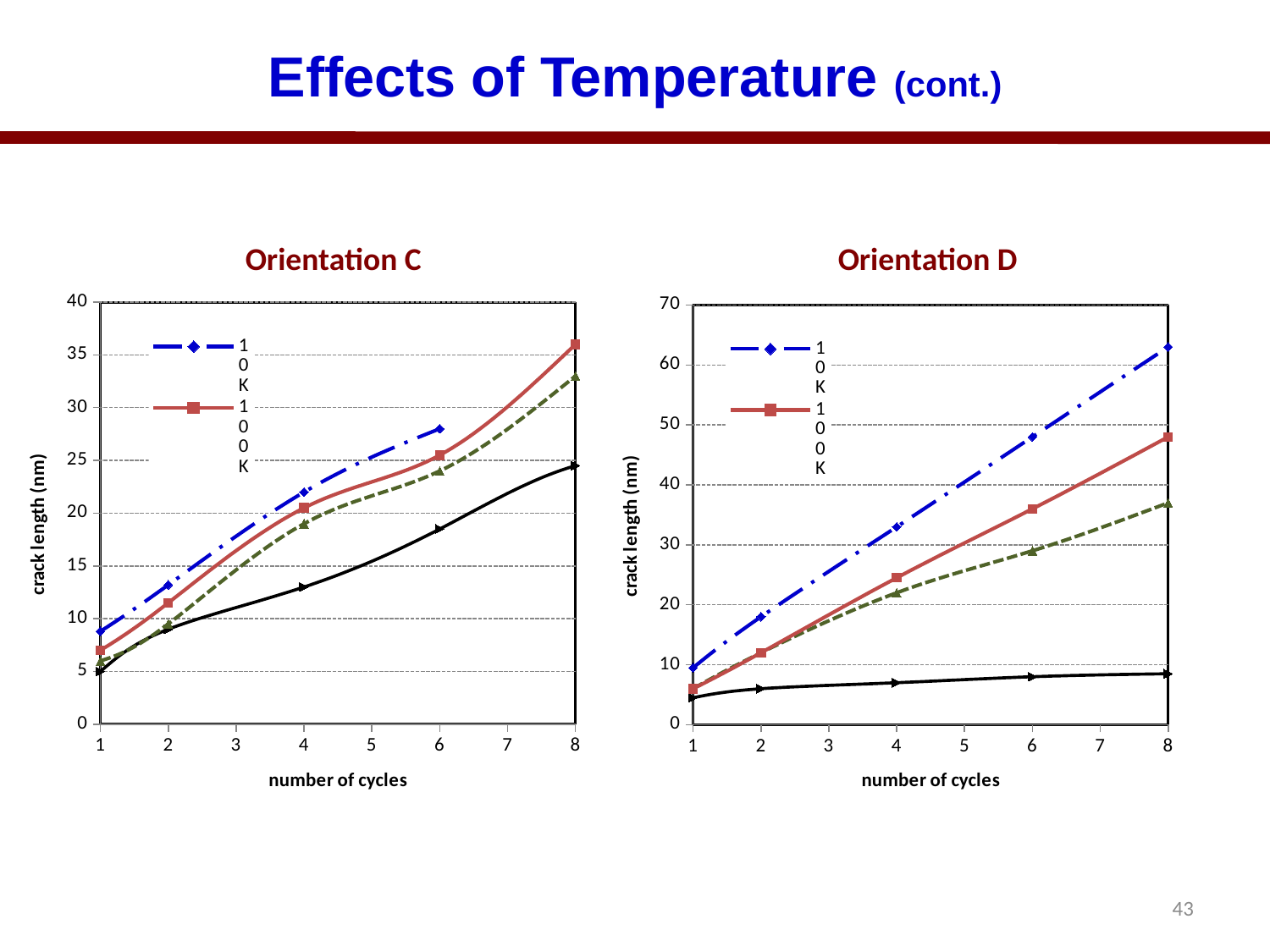
In the Orientation C chart, is the value of the 100K series at 8 cycles greater or less than 30? greater In the Orientation D chart, does the 10K series rise or fall as the number of cycles increases? rise What is the highest value shown on the y axis of the Orientation D chart? 70 In the Orientation D chart, how many series does the legend list? 2 In the Orientation D chart, is the value of the 100K series at 4 cycles greater or less than 20? greater In the Orientation C chart, is the value of the 100K series at 2 cycles greater or less than 15? less In the Orientation C chart, what are the two legend entries? 10K and 100K What kind of chart is the Orientation C chart? line chart In the Orientation D chart, which series is larger at 8 cycles, 10K or 100K? 10K